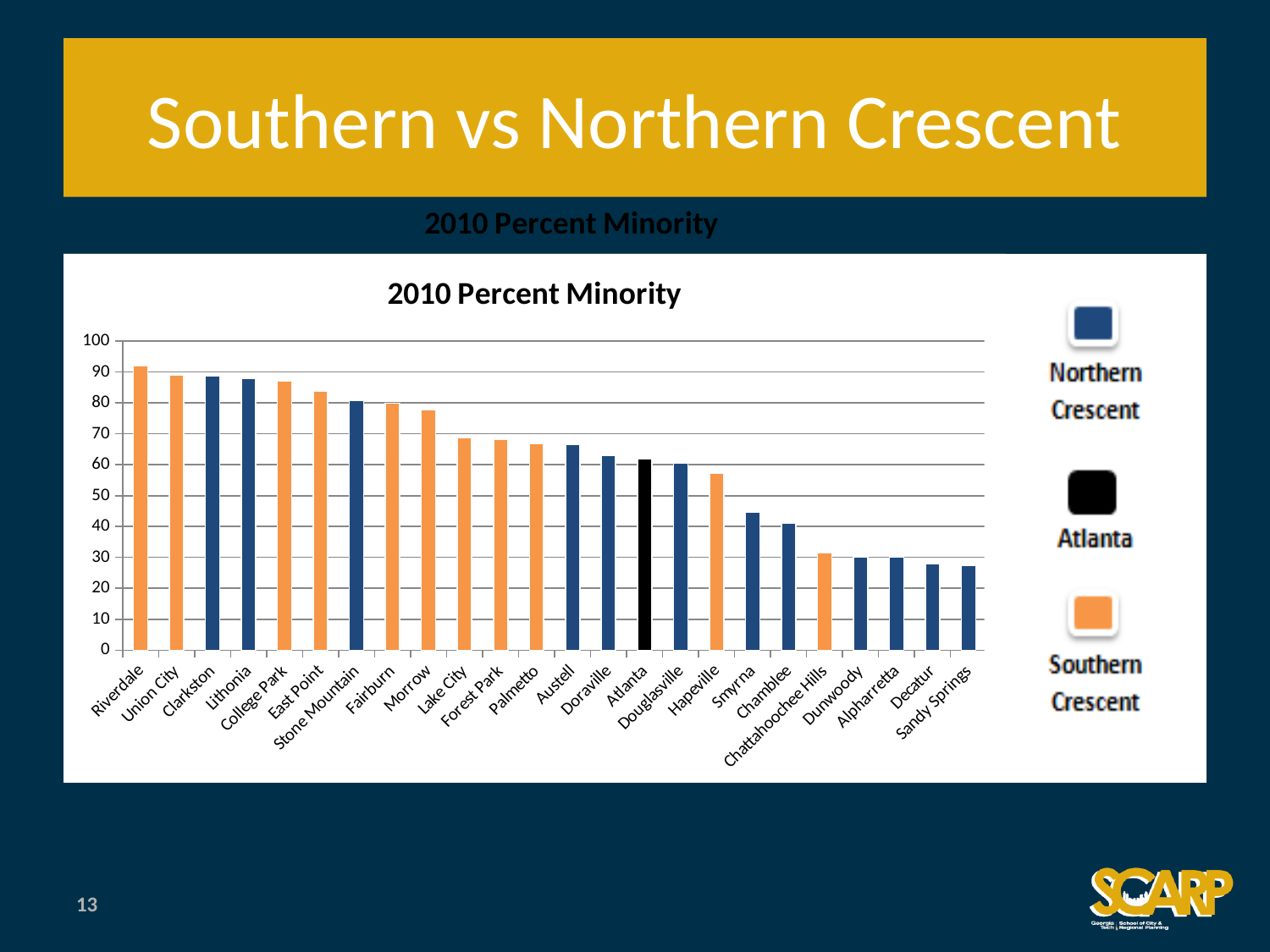
Is the value for Riverdale greater or less than 90? greater Is the value for Atlanta greater or less than 70? less Which city has the highest 2010 percent minority? Riverdale Is the value for Clarkston greater or less than 80? greater What kind of chart is shown on the slide? bar chart What is the title of the chart? 2010 Percent Minority Do the values generally rise or fall moving from left to right along the x axis? fall What colour is the bar for Atlanta? black How many entries does the legend list? 3 Which has a higher value, Hapeville or Smyrna? Hapeville How many categories (cities) are plotted on the x axis? 24